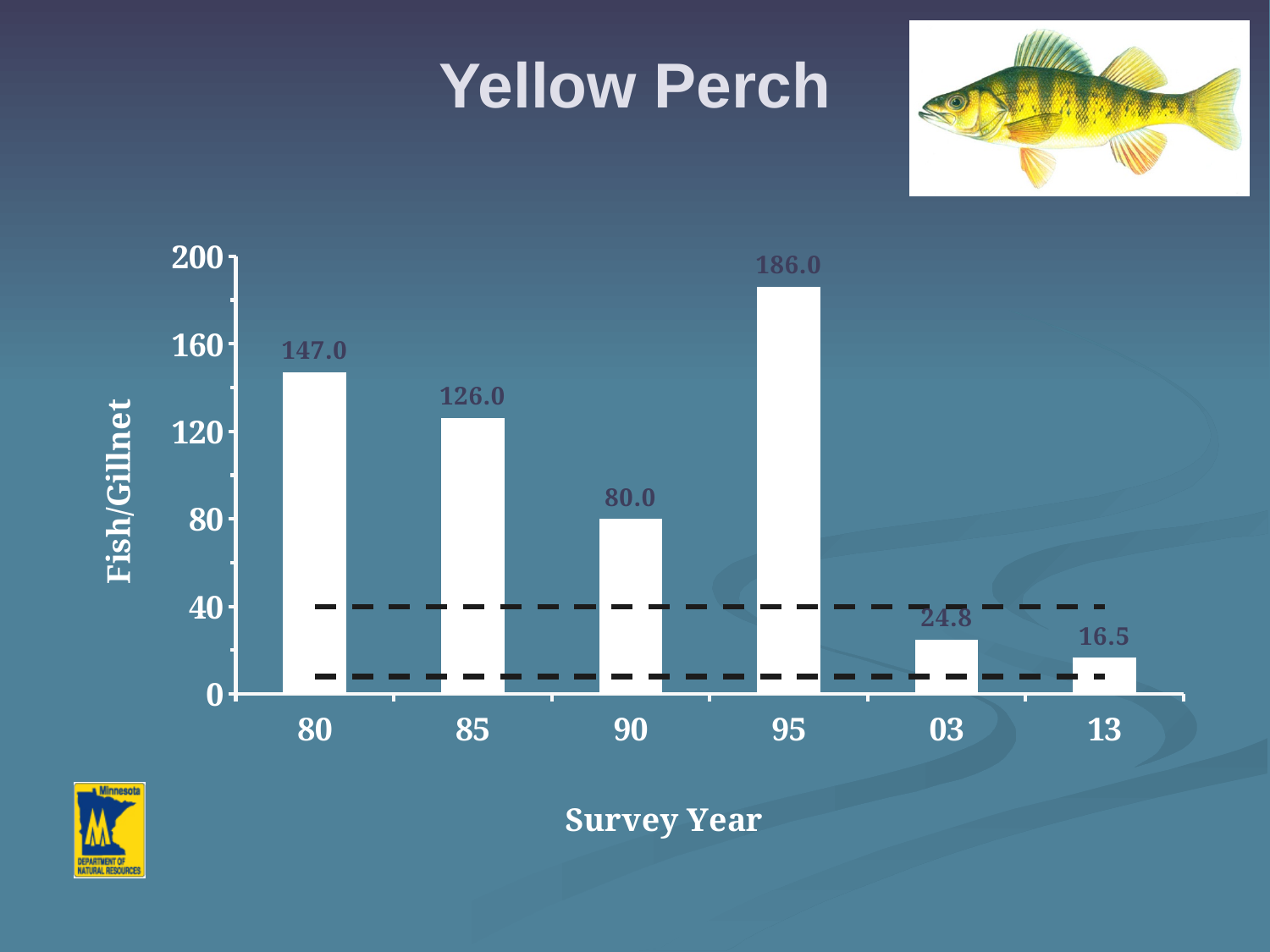
What is the Fish/Gillnet value for survey year 13? 16.5 What is the Fish/Gillnet value for survey year 80? 147.0 What is the Fish/Gillnet value for survey year 03? 24.8 Which survey year has a larger Fish/Gillnet value, 80 or 85? 80 Is the value for survey year 90 greater or less than 120? less What is the Fish/Gillnet value for survey year 95? 186.0 How many survey years are shown on the chart? 6 What is the difference between the Fish/Gillnet values for survey years 95 and 90? 106.0 Which survey year has the lowest Fish/Gillnet value? 13 Which survey year has the highest Fish/Gillnet value? 95 What is the label of the y axis? Fish/Gillnet What kind of chart is shown on the slide? bar chart